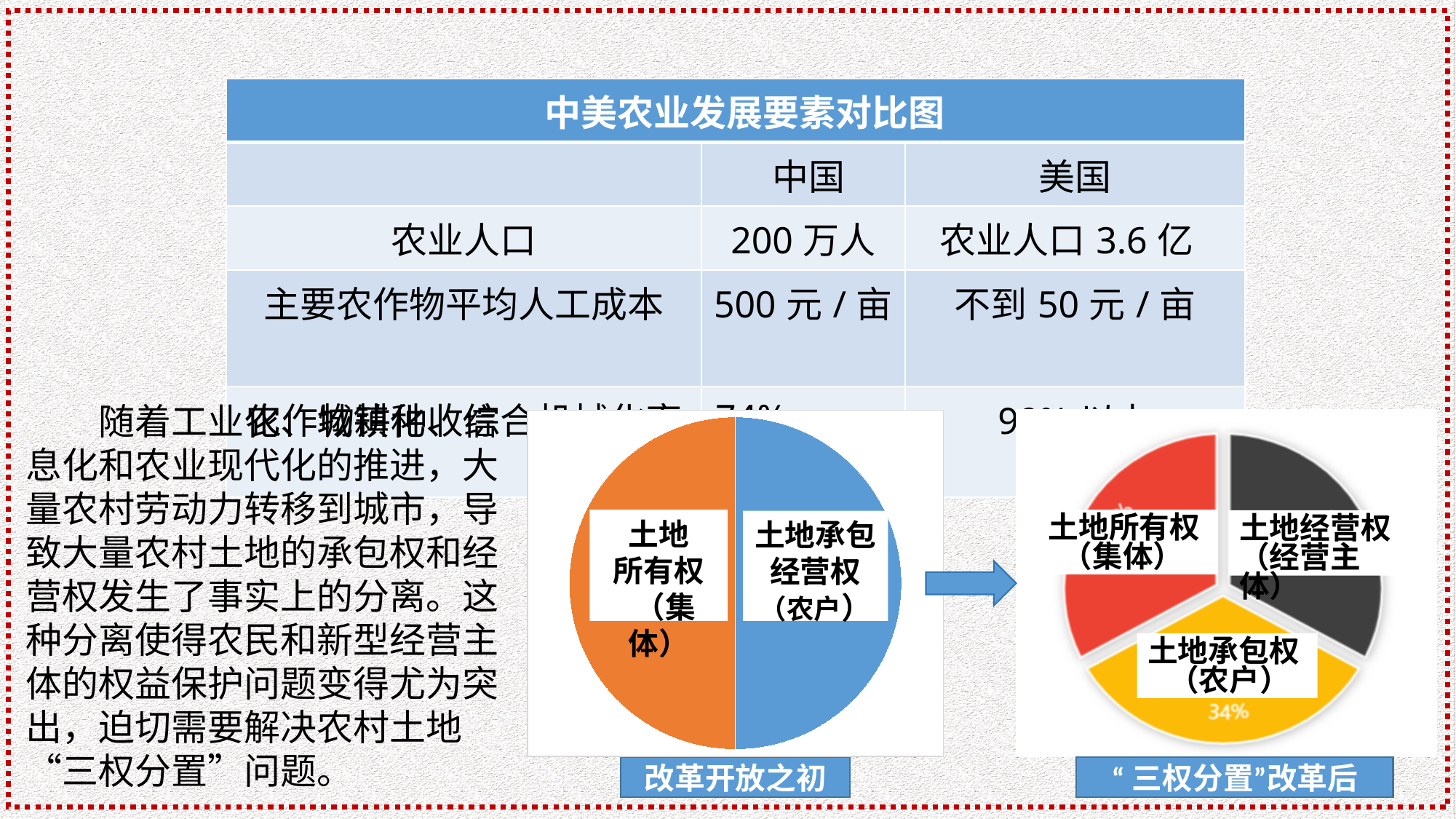
In the 改革开放之初 pie chart, which slice is coloured orange? 土地所有权（集体） In the “三权分置”改革后 pie chart, which slice is coloured dark grey? 土地经营权（经营主体） In the “三权分置”改革后 pie chart, which slice is coloured yellow? 土地承包权（农户） What kind of chart is the one labelled “三权分置”改革后? pie chart In the “三权分置”改革后 pie chart, which slice is coloured red? 土地所有权（集体） In the “三权分置”改革后 pie chart, is the share for 土地承包权（农户） greater or less than 50%? less In the 改革开放之初 pie chart, which slice is coloured blue? 土地承包经营权（农户） What kind of chart is the one labelled 改革开放之初? pie chart How many slices does the “三权分置”改革后 pie chart have? 3 How many slices does the 改革开放之初 pie chart have? 2 In the “三权分置”改革后 pie chart, what share is shown for 土地承包权（农户）? 34%